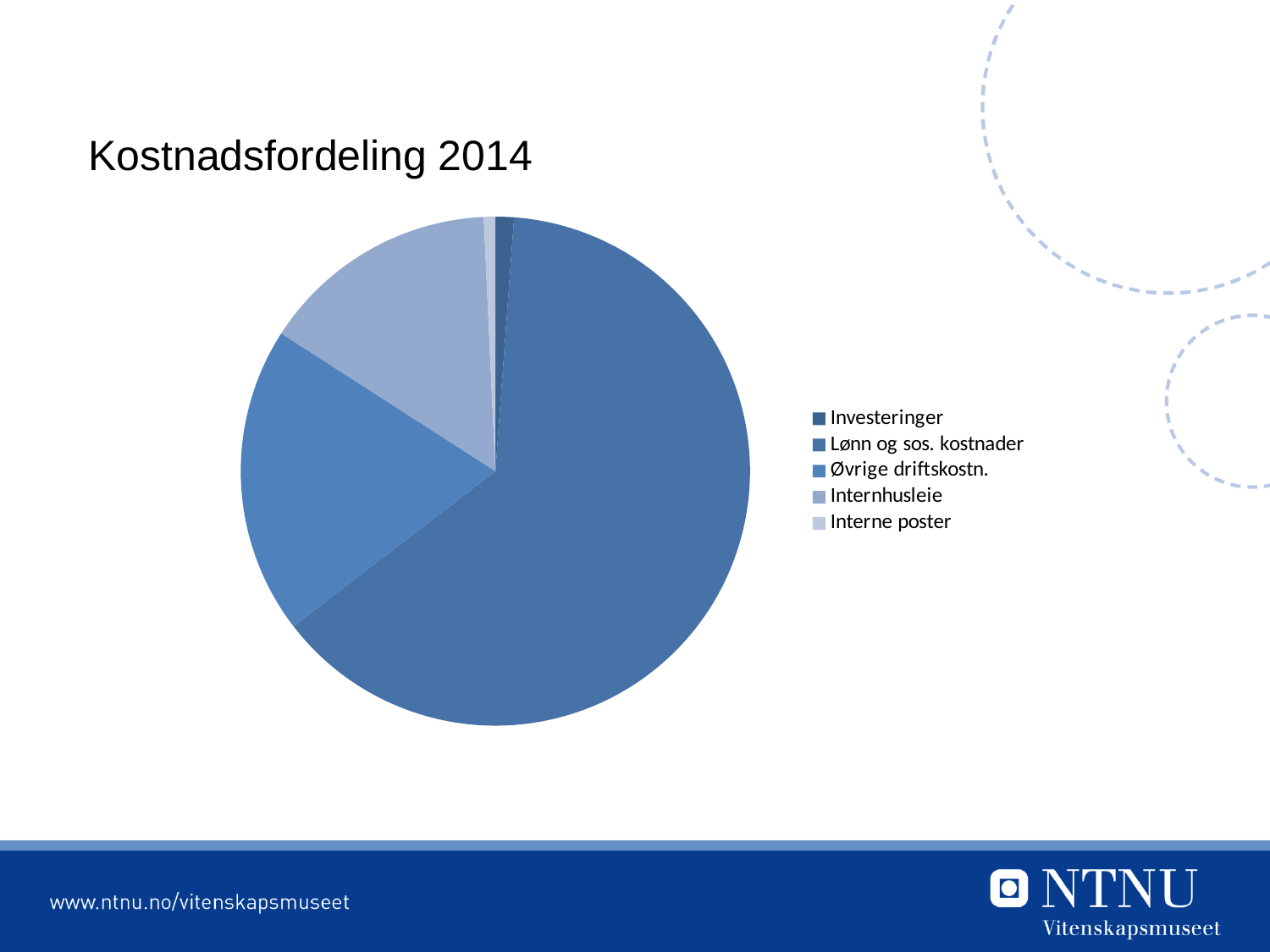
Does the Lønn og sos. kostnader slice take up more or less than half of the pie? more Which category has the largest slice of the pie chart? Lønn og sos. kostnader Which slice is larger, Lønn og sos. kostnader or Øvrige driftskostn.? Lønn og sos. kostnader Which slice is larger, Lønn og sos. kostnader or Interne poster? Lønn og sos. kostnader Which category is listed first in the pie chart's legend? Investeringer How many categories does the pie chart's legend list? 5 What kind of chart is shown on the slide? pie chart What is the title of the slide containing the pie chart? Kostnadsfordeling 2014